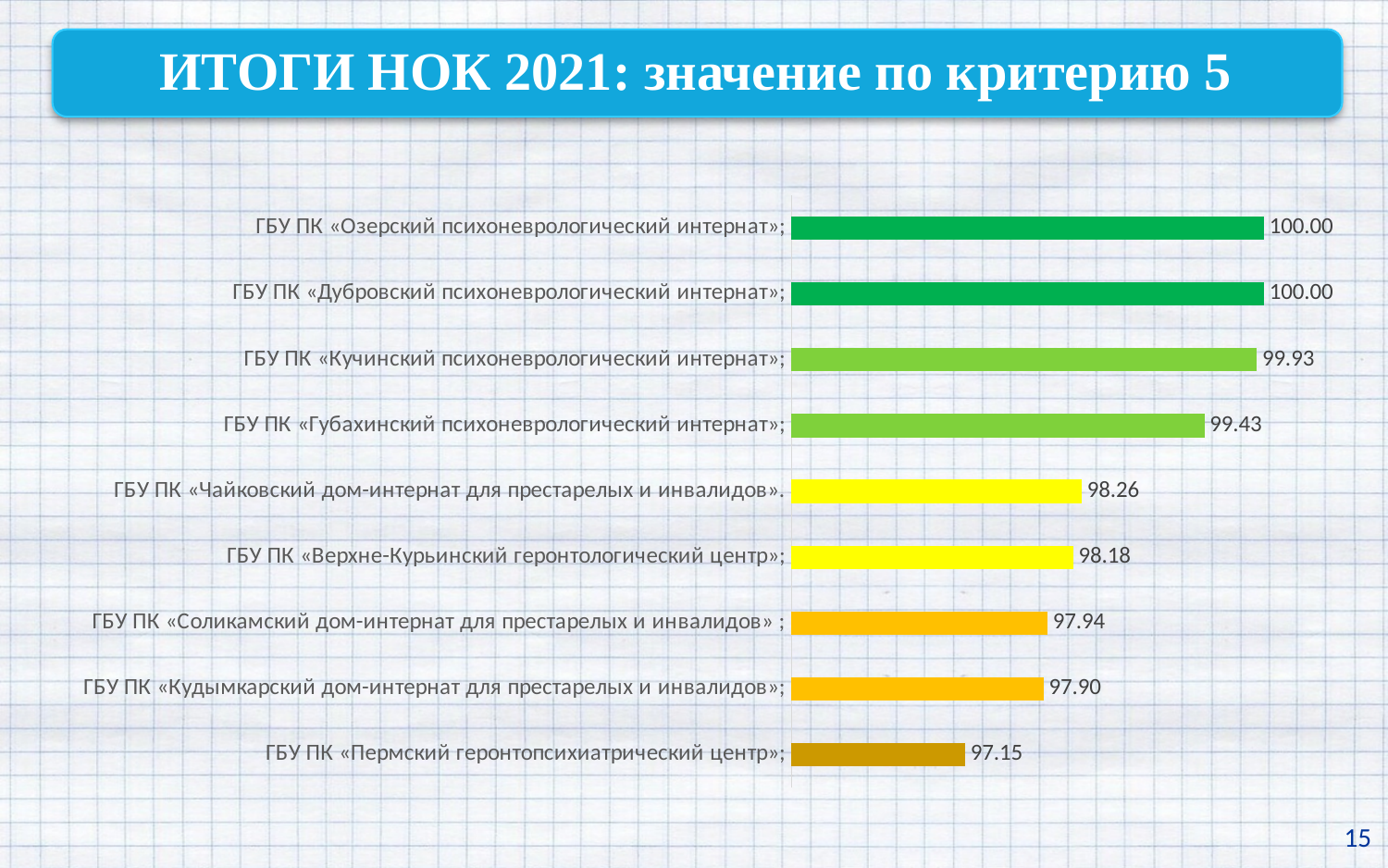
What is the value for ГБУ ПК «Соликамский дом-интернат для престарелых и инвалидов»? 97.94 How many categories are shown in the chart? 9 Which has a larger value: ГБУ ПК «Кучинский психоневрологический интернат» or ГБУ ПК «Губахинский психоневрологический интернат»? ГБУ ПК «Кучинский психоневрологический интернат» What is the value for ГБУ ПК «Кучинский психоневрологический интернат»? 99.93 What is the difference between the value for ГБУ ПК «Озерский психоневрологический интернат» and ГБУ ПК «Пермский геронтопсихиатрический центр»? 2.85 What is the difference between the values for ГБУ ПК «Кучинский психоневрологический интернат» and ГБУ ПК «Губахинский психоневрологический интернат»? 0.50 What type of chart is shown on the slide? Bar chart What is the value for ГБУ ПК «Чайковский дом-интернат для престарелых и инвалидов»? 98.26 Which category has the lowest value? ГБУ ПК «Пермский геронтопсихиатрический центр» Which categories share the highest value of 100.00? ГБУ ПК «Озерский психоневрологический интернат» and ГБУ ПК «Дубровский психоневрологический интернат» What is the value for ГБУ ПК «Пермский геронтопсихиатрический центр»? 97.15 What is the value for ГБУ ПК «Губахинский психоневрологический интернат»? 99.43